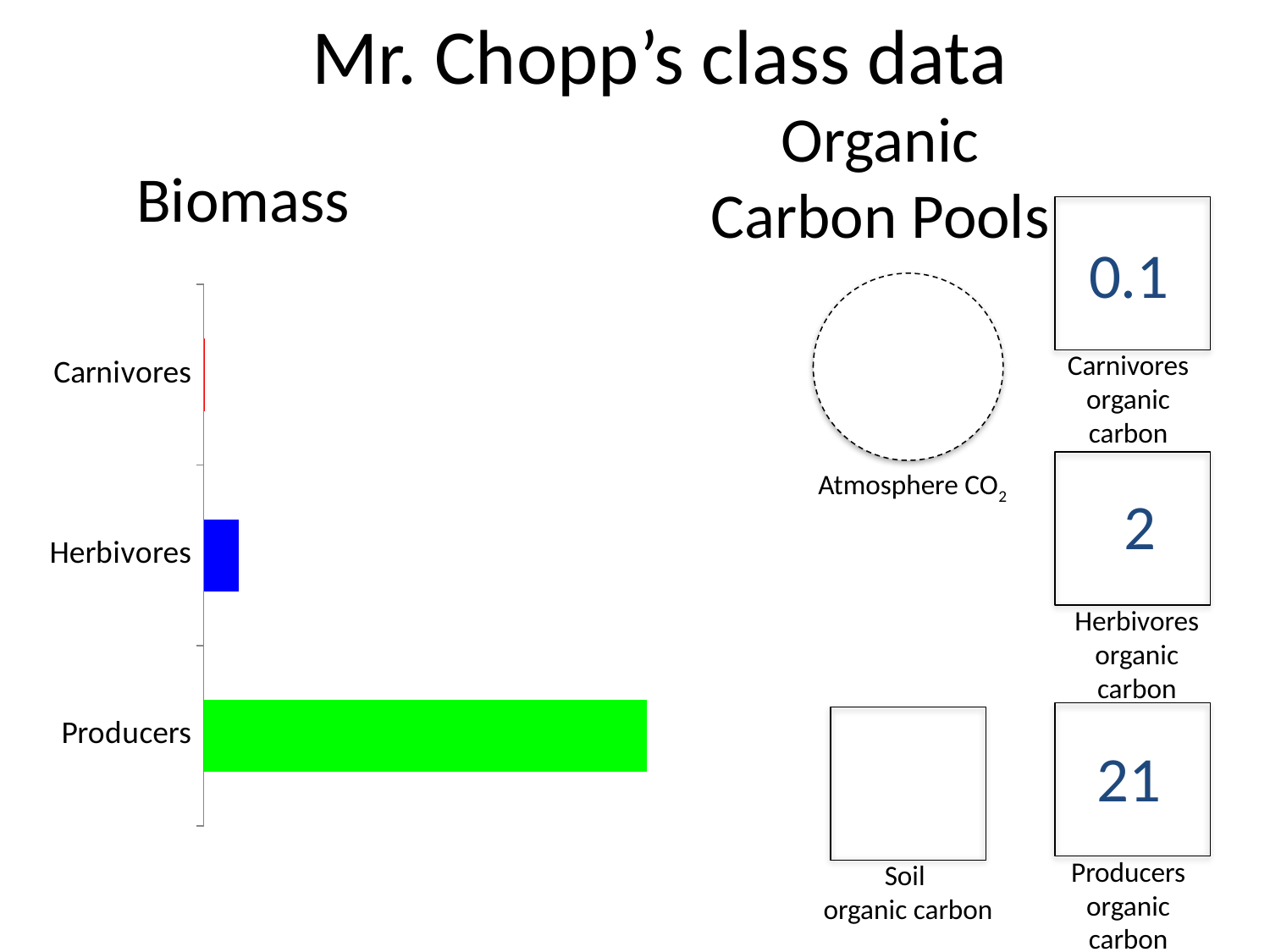
What colour is the Producers bar in the Biomass chart? green In the Biomass chart, which is larger, the bar for Producers or the bar for Herbivores? Producers What kind of chart is the Biomass chart? bar chart Which category has the lowest biomass in the Biomass chart? Carnivores In the Biomass chart, which is larger, the bar for Herbivores or the bar for Carnivores? Herbivores Which category has the highest biomass in the Biomass chart? Producers How many categories does the Biomass chart show? 3 What is the title of the bar chart on the left of the slide? Biomass